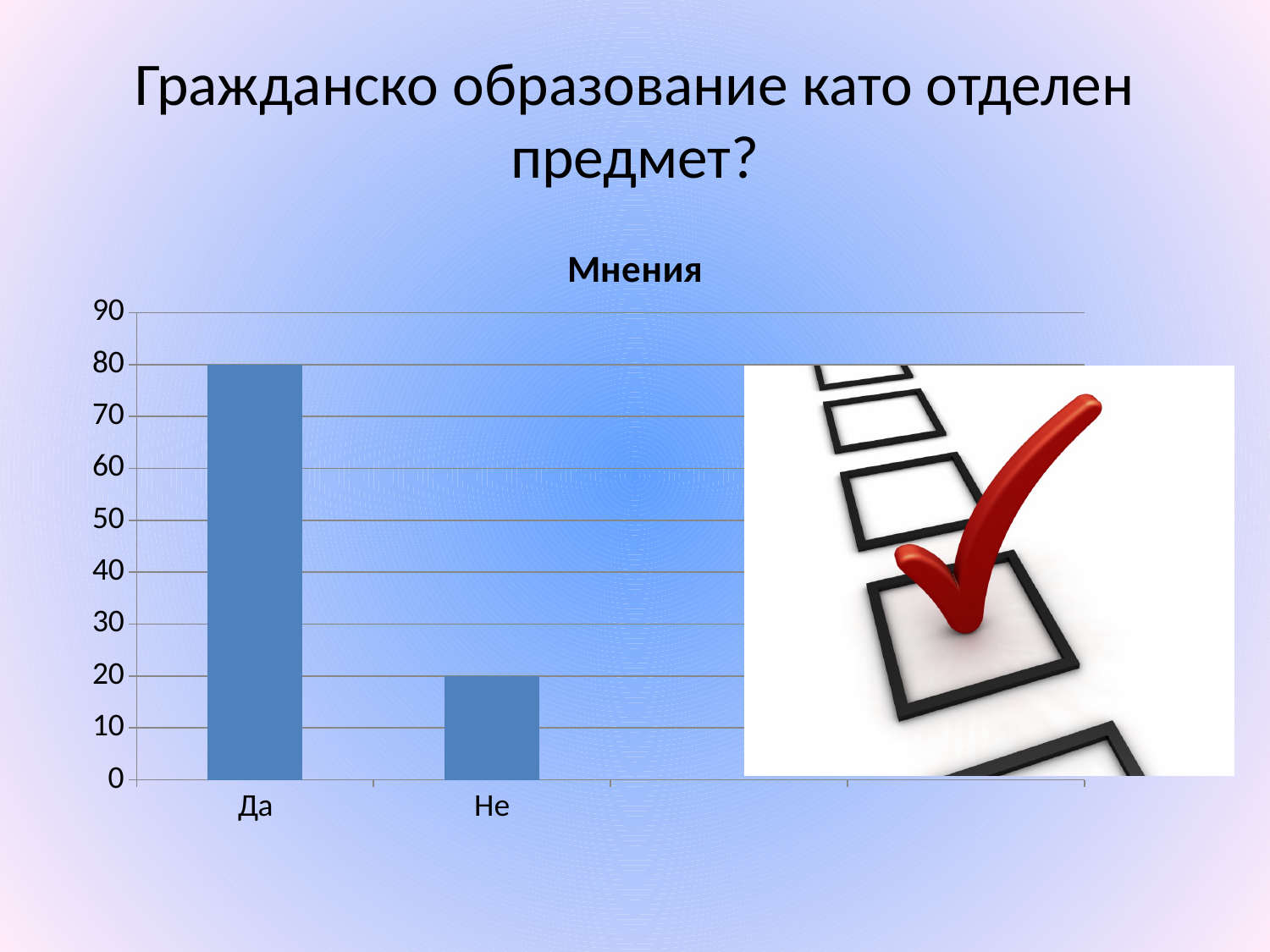
What is the highest value shown on the y axis of the chart? 90 Which category has the lowest value? Не How many categories are shown on the x axis of the chart? 2 What is the value for Да? 80 Is the value for Да greater or less than 50? greater What is the title of the chart? Мнения What type of chart is shown on the slide? bar chart Is the value for Не greater or less than 30? less Which is larger, the value for Да or the value for Не? Да What is the value for Не? 20 Which category has the highest value? Да What is the difference between the values for Да and Не? 60